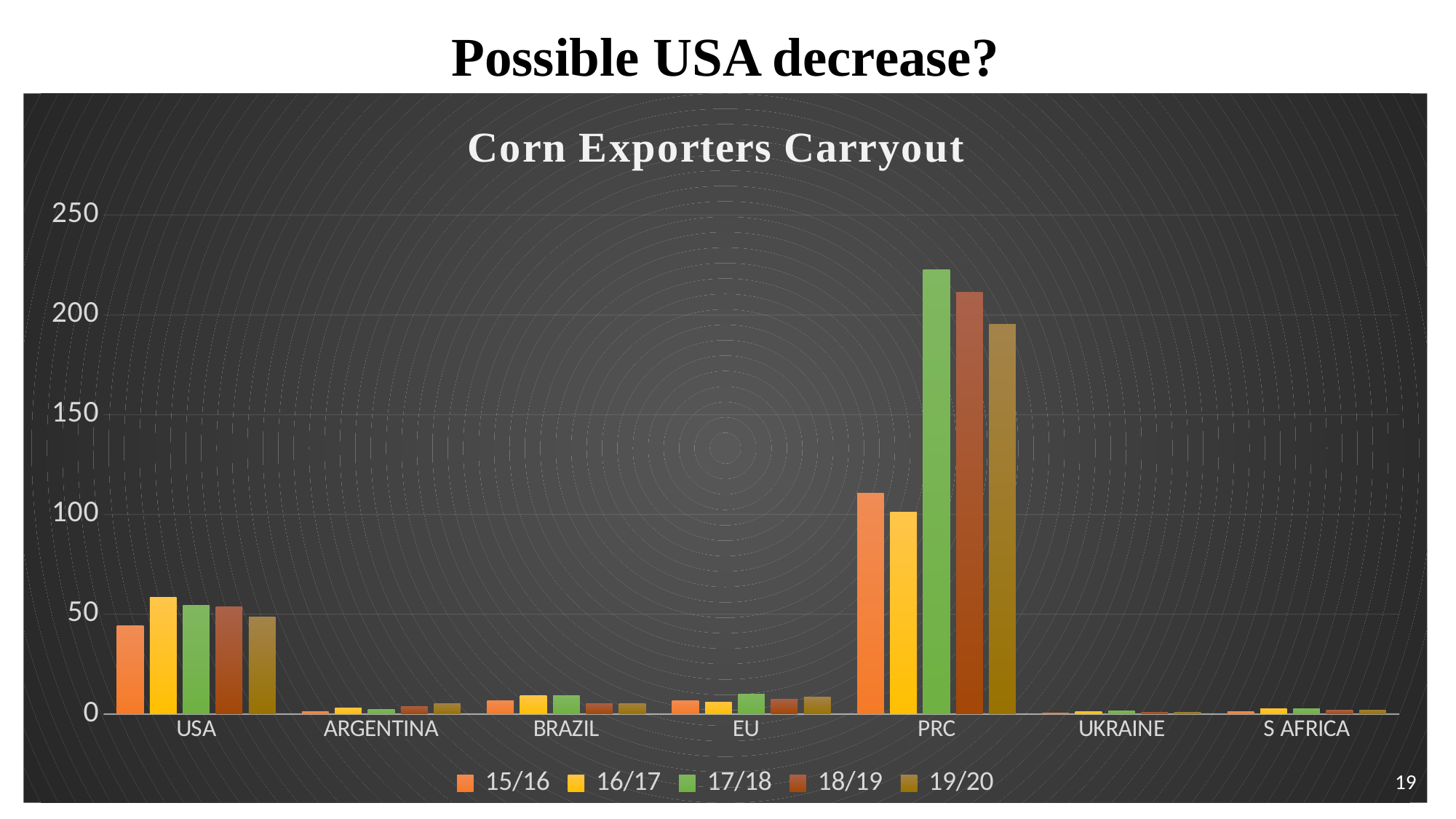
Is the 16/17 value for USA greater or less than 50? greater What is the title of the chart? Corn Exporters Carryout Is the 15/16 value for USA greater or less than 50? less Is the 17/18 value for PRC greater or less than 200? greater What kind of chart is shown on the slide? bar chart For PRC, which is larger: the 18/19 value or the 19/20 value? 18/19 For USA, which is larger: the 15/16 value or the 16/17 value? 16/17 Which category has the highest 17/18 value? PRC How many series does the legend list? 5 How many countries or regions are shown on the x axis? 7